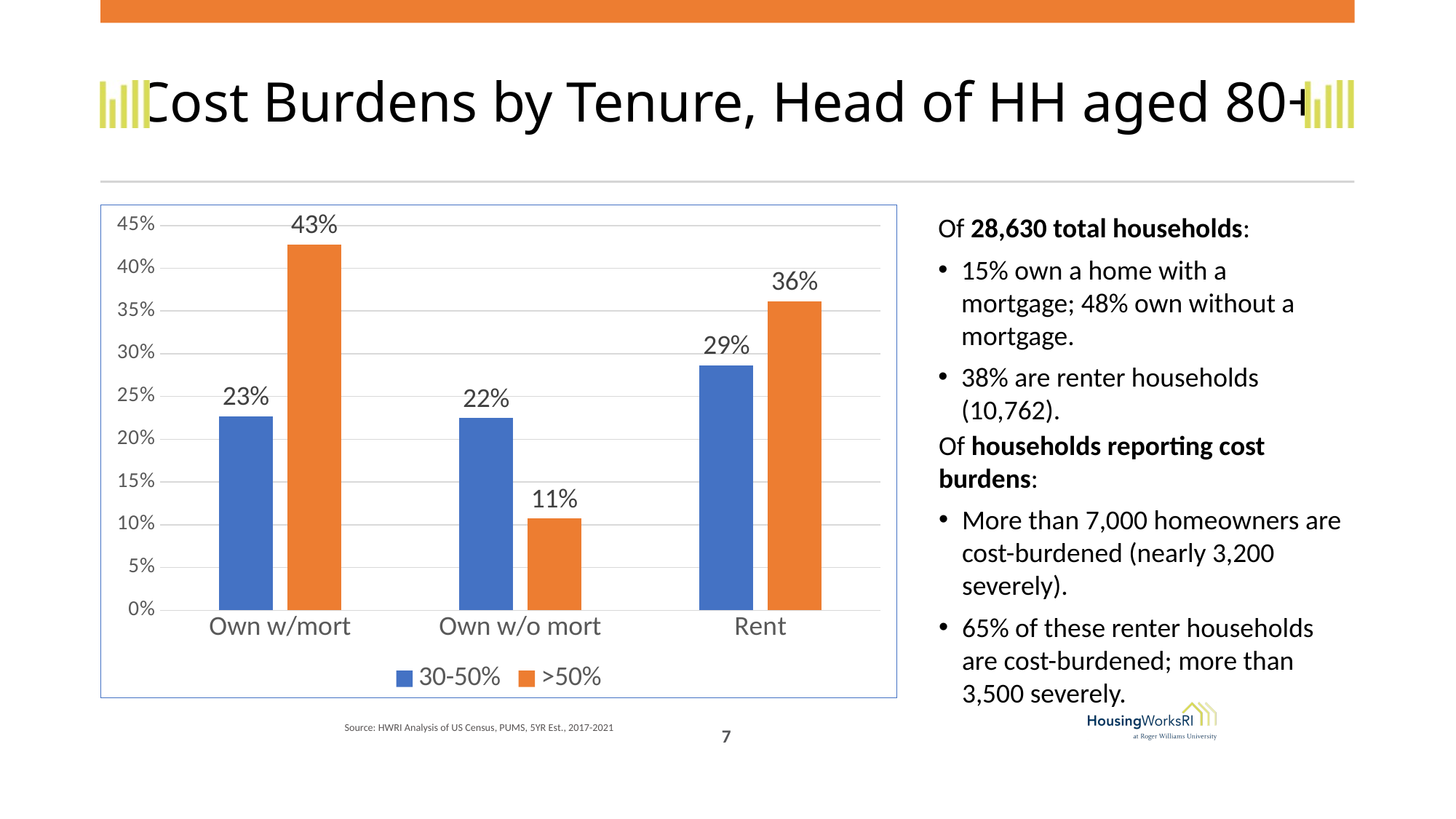
How many categories are shown on the x axis? 3 How many series does the legend list? 2 Which is larger for Own w/o mort: the 30-50% value or the >50% value? 30-50% What is the value of the 30-50% series for Rent? 29% What is the value of the >50% series for Own w/mort? 43% Which category has the lowest value in the >50% series? Own w/o mort Which colour represents the >50% series in the chart? Orange What is the difference between the >50% and 30-50% values for Rent? 7% What is the value of the >50% series for Own w/o mort? 11% Which category has the highest value in the >50% series? Own w/mort What kind of chart is shown on the slide? Bar chart What is the value of the 30-50% series for Own w/mort? 23%